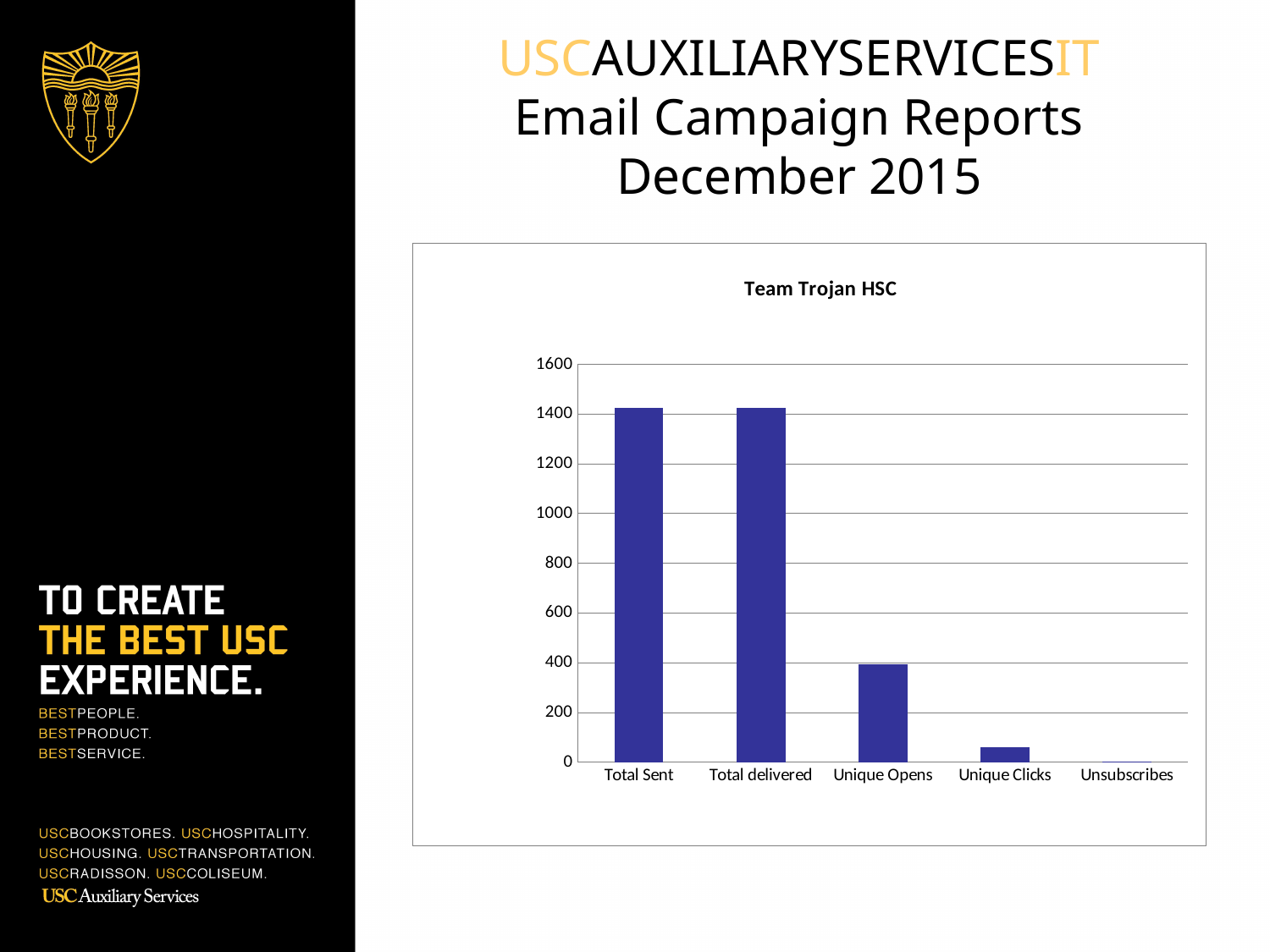
Is the value for Unique Opens greater or less than 200? greater What kind of chart is shown on the slide? bar chart Which is larger, the value for Total delivered or the value for Unique Opens? Total delivered What is the title of the chart? Team Trojan HSC Which category has the lowest value in the chart? Unsubscribes How many categories are shown on the x axis of the chart? 5 Is the value for Unique Clicks greater or less than 200? less What is the highest value shown on the y axis of the chart? 1600 Is the value for Unique Opens greater or less than 600? less Which is larger, the value for Unique Clicks or the value for Unsubscribes? Unique Clicks